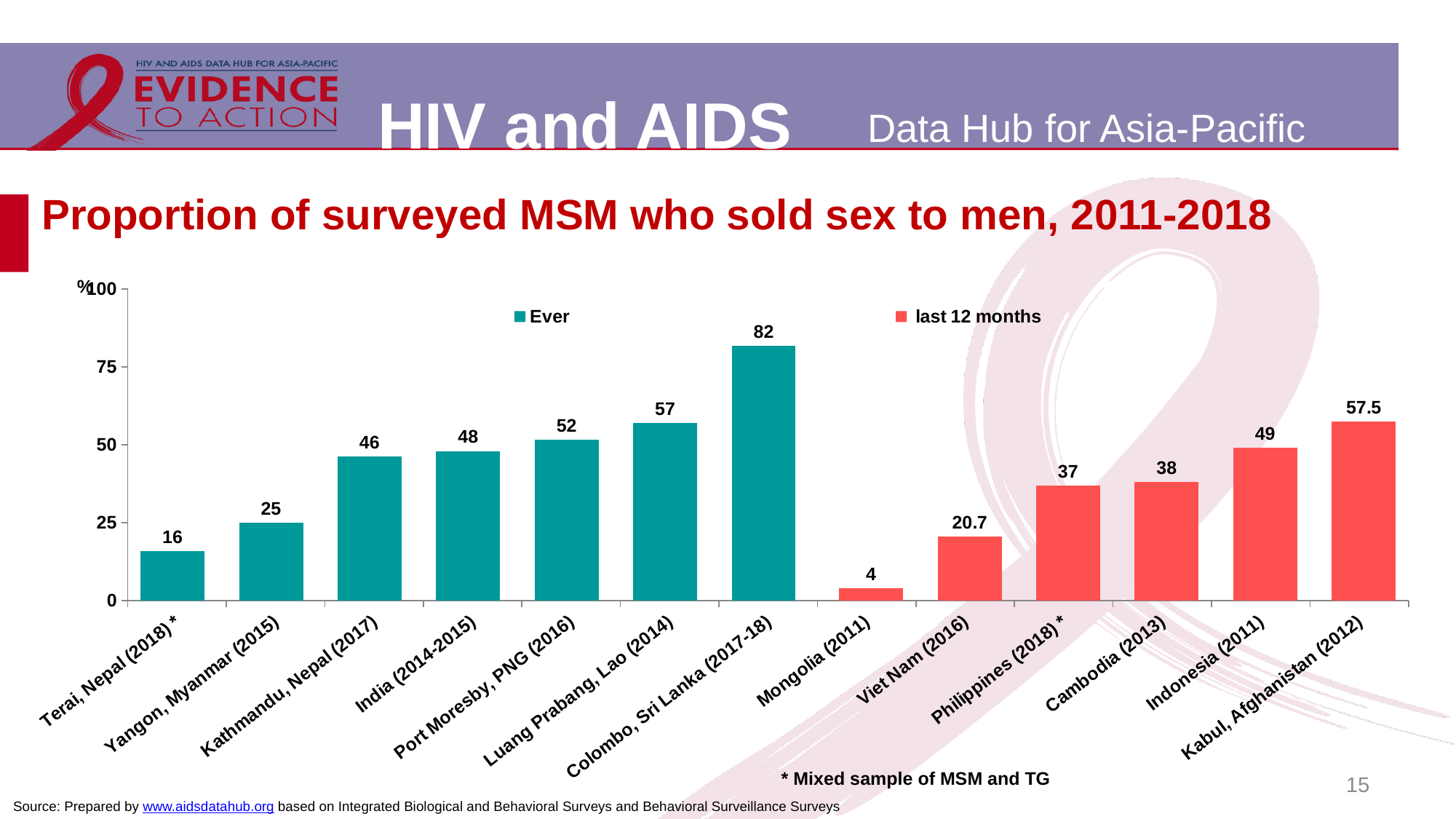
Is the value for Philippines (2018)* greater or less than 50? less Which category has the lowest value? Mongolia (2011) Which category has the highest value? Colombo, Sri Lanka (2017-18) What is the value for Viet Nam (2016)? 20.7 Which is larger, the value for Indonesia (2011) or the value for Kathmandu, Nepal (2017)? Indonesia (2011) How many series does the legend list? 2 What is the difference between the values for Luang Prabang, Lao (2014) and Port Moresby, PNG (2016)? 5 What is the value for Kabul, Afghanistan (2012)? 57.5 What kind of chart is shown on the slide? bar chart Which series do the red bars represent? last 12 months How many categories are shown on the x axis? 13 What is the value for Colombo, Sri Lanka (2017-18)? 82